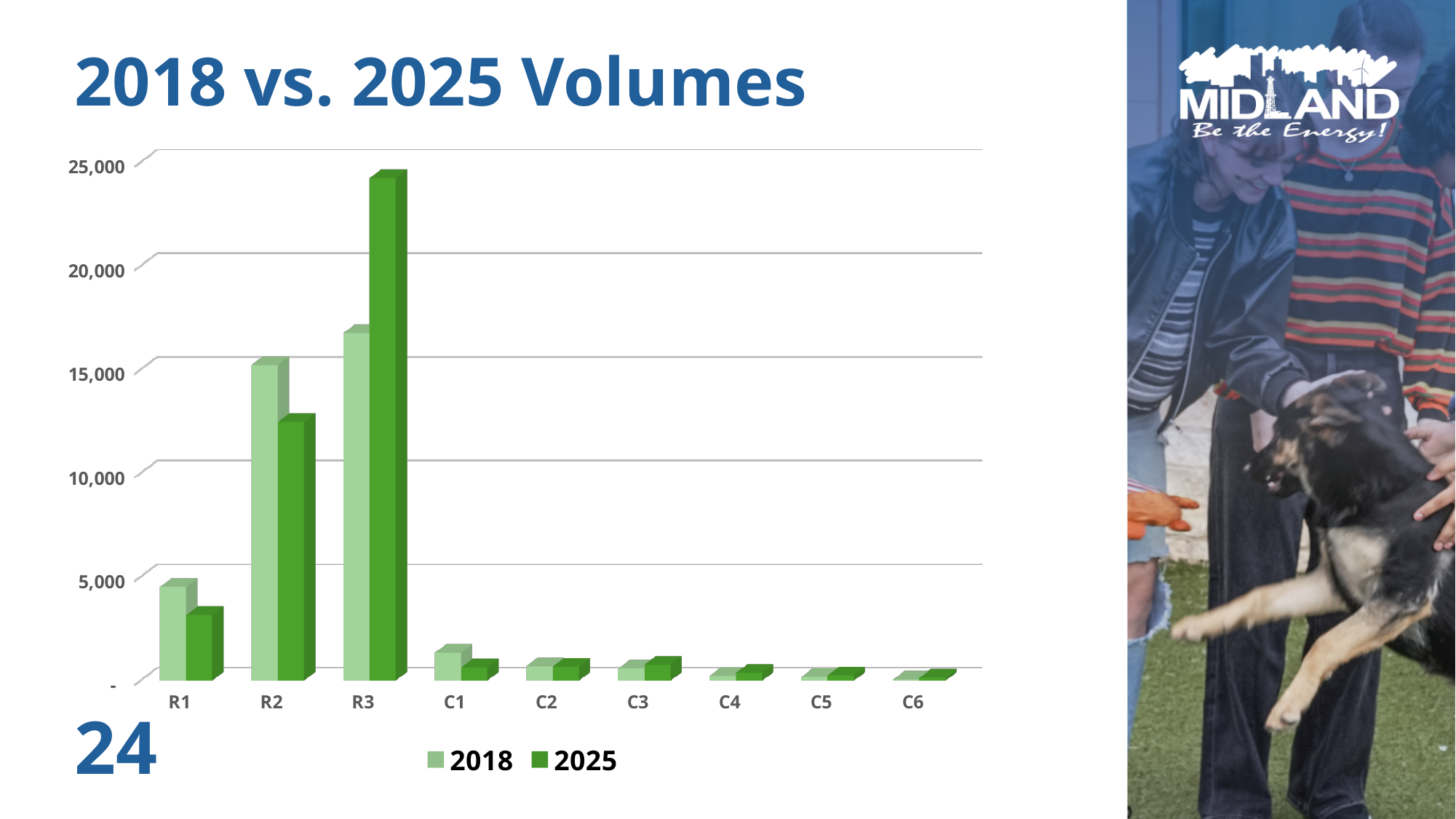
How many series does the chart's legend list? 2 For R3, which series has the larger value, 2018 or 2025? 2025 What is the title of the chart on the slide? 2018 vs. 2025 Volumes Is the 2025 value for R2 greater or less than 10,000? greater What kind of chart is shown on the slide? Bar chart How many categories are shown on the x axis of the chart? 9 Is the 2018 value for R1 greater or less than 5,000? less Which category has the highest 2025 value? R3 Is the 2025 value for R3 greater or less than 20,000? greater Which category has the highest 2018 value? R3 For R2, which series has the larger value, 2018 or 2025? 2018 Which series is shown in the darker green colour? 2025